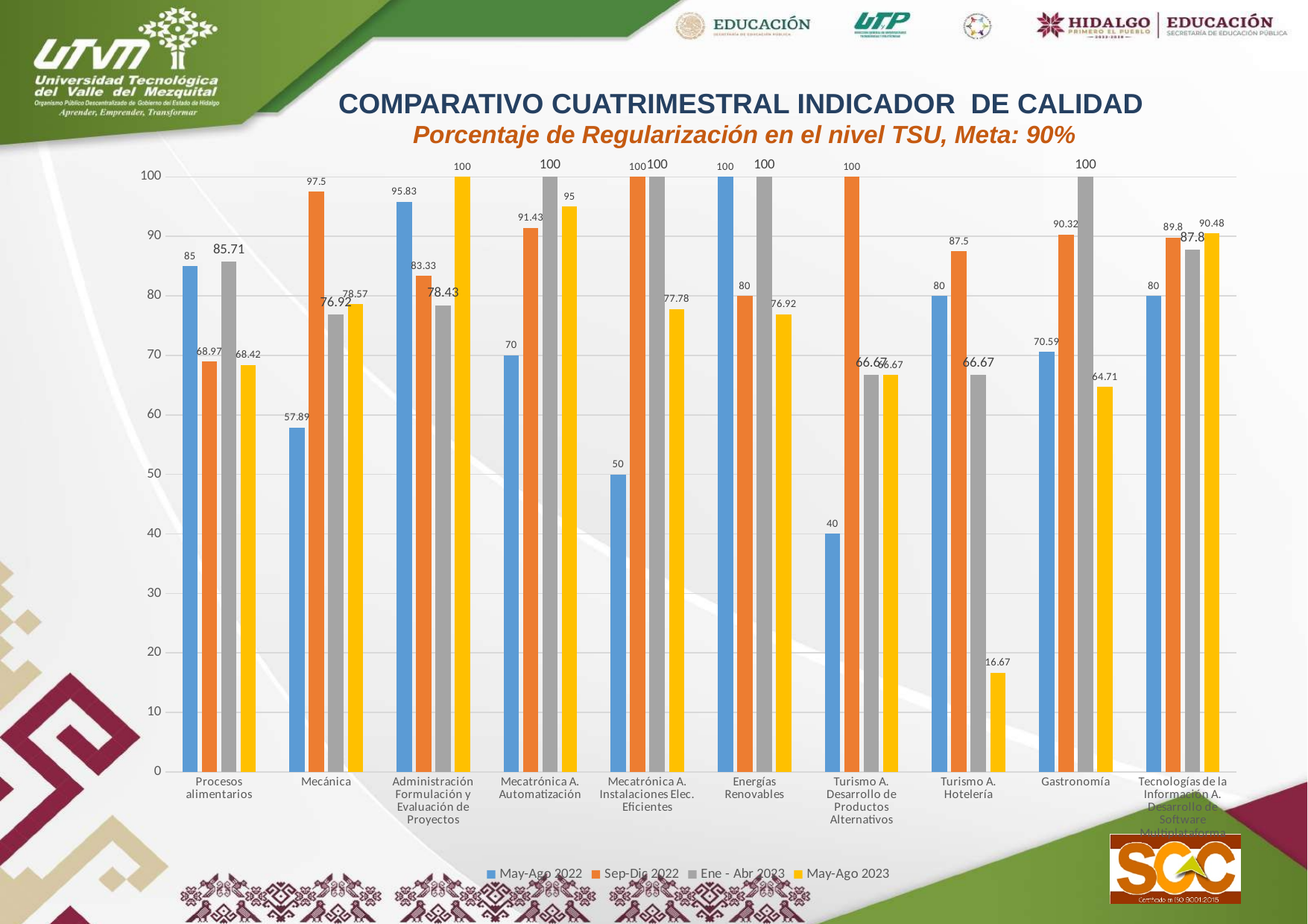
Which is larger for Procesos alimentarios: the May-Ago 2022 value or the Ene - Abr 2023 value? Ene - Abr 2023 What kind of chart is shown on the slide? bar chart Which category has the lowest value in the May-Ago 2023 series? Turismo A. Hotelería What is the difference between the Sep-Dic 2022 and May-Ago 2022 values for Mecánica? 39.61 How many series does the legend list? 4 What target (Meta) is stated in the chart subtitle? 90% What is the value for Mecánica in the Sep-Dic 2022 series? 97.5 How many categories are shown on the x axis? 10 Is the May-Ago 2022 value for Mecatrónica A. Instalaciones Elec. Eficientes greater or less than 60? less What is the value for Gastronomía in the Sep-Dic 2022 series? 90.32 What is the value for Turismo A. Hotelería in the May-Ago 2023 series? 16.67 Which category has the lowest value in the May-Ago 2022 series? Turismo A. Desarrollo de Productos Alternativos